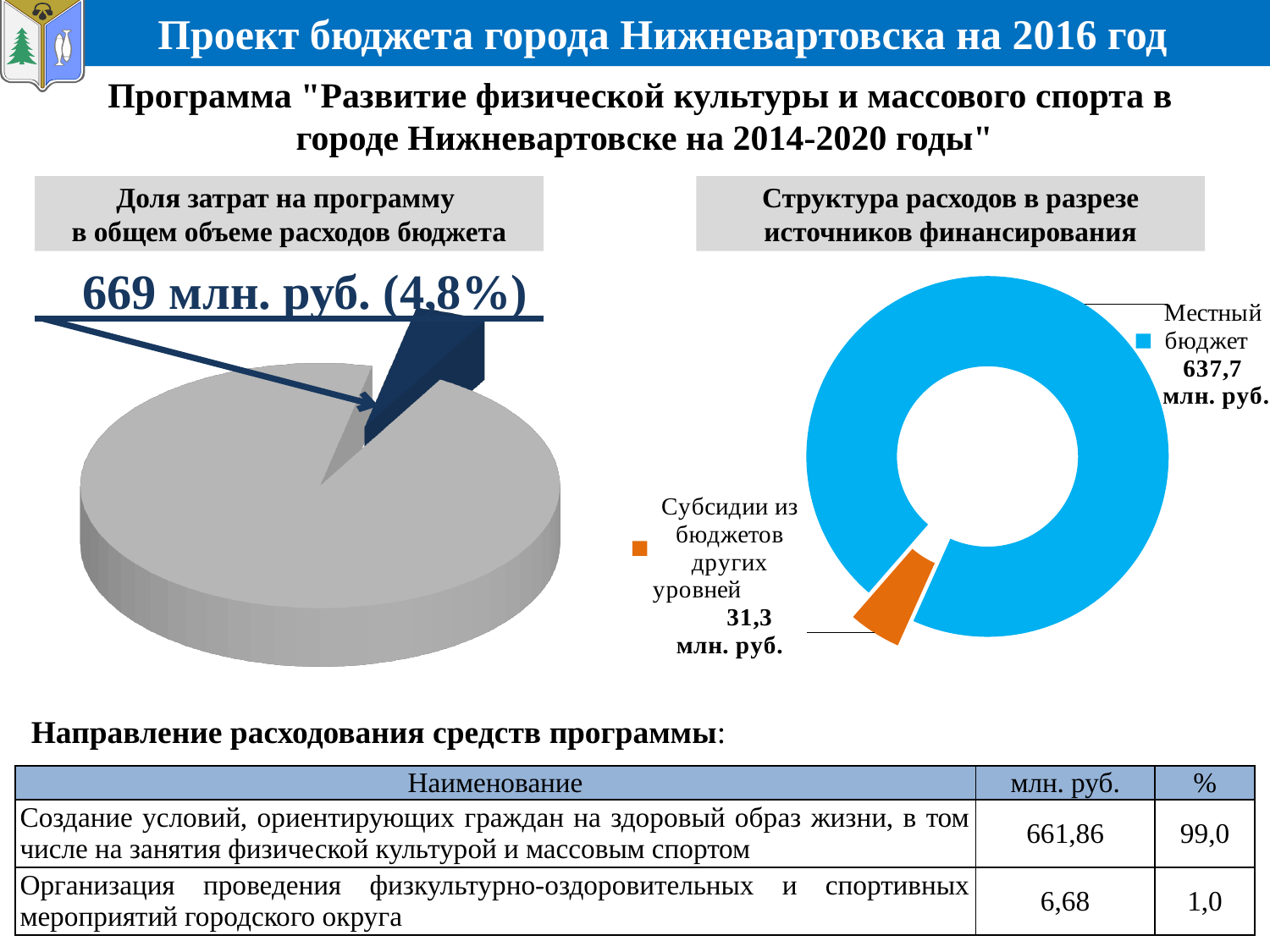
In the chart 'Доля затрат на программу в общем объеме расходов бюджета', what share of the total budget expenditure does the programme represent? 4,8% In the chart 'Структура расходов в разрезе источников финансирования', what is the value for 'Субсидии из бюджетов других уровней'? 31,3 млн. руб. How many categories does the chart 'Структура расходов в разрезе источников финансирования' show? 2 In the chart 'Доля затрат на программу в общем объеме расходов бюджета', what value is labelled on the highlighted slice? 669 млн. руб. (4,8%) In the chart 'Структура расходов в разрезе источников финансирования', what is the value for 'Местный бюджет'? 637,7 млн. руб. In the chart 'Структура расходов в разрезе источников финансирования', which source of financing has the smallest value? Субсидии из бюджетов других уровней In the chart 'Структура расходов в разрезе источников финансирования', which source of financing has the largest value? Местный бюджет What kind of chart is 'Доля затрат на программу в общем объеме расходов бюджета'? Pie chart What kind of chart is 'Структура расходов в разрезе источников финансирования'? Doughnut chart In the chart 'Структура расходов в разрезе источников финансирования', which is larger: 'Местный бюджет' or 'Субсидии из бюджетов других уровней'? Местный бюджет In the chart 'Структура расходов в разрезе источников финансирования', what colour is the 'Местный бюджет' slice? Blue In the chart 'Структура расходов в разрезе источников финансирования', what is the difference between 'Местный бюджет' and 'Субсидии из бюджетов других уровней'? 606,4 млн. руб.